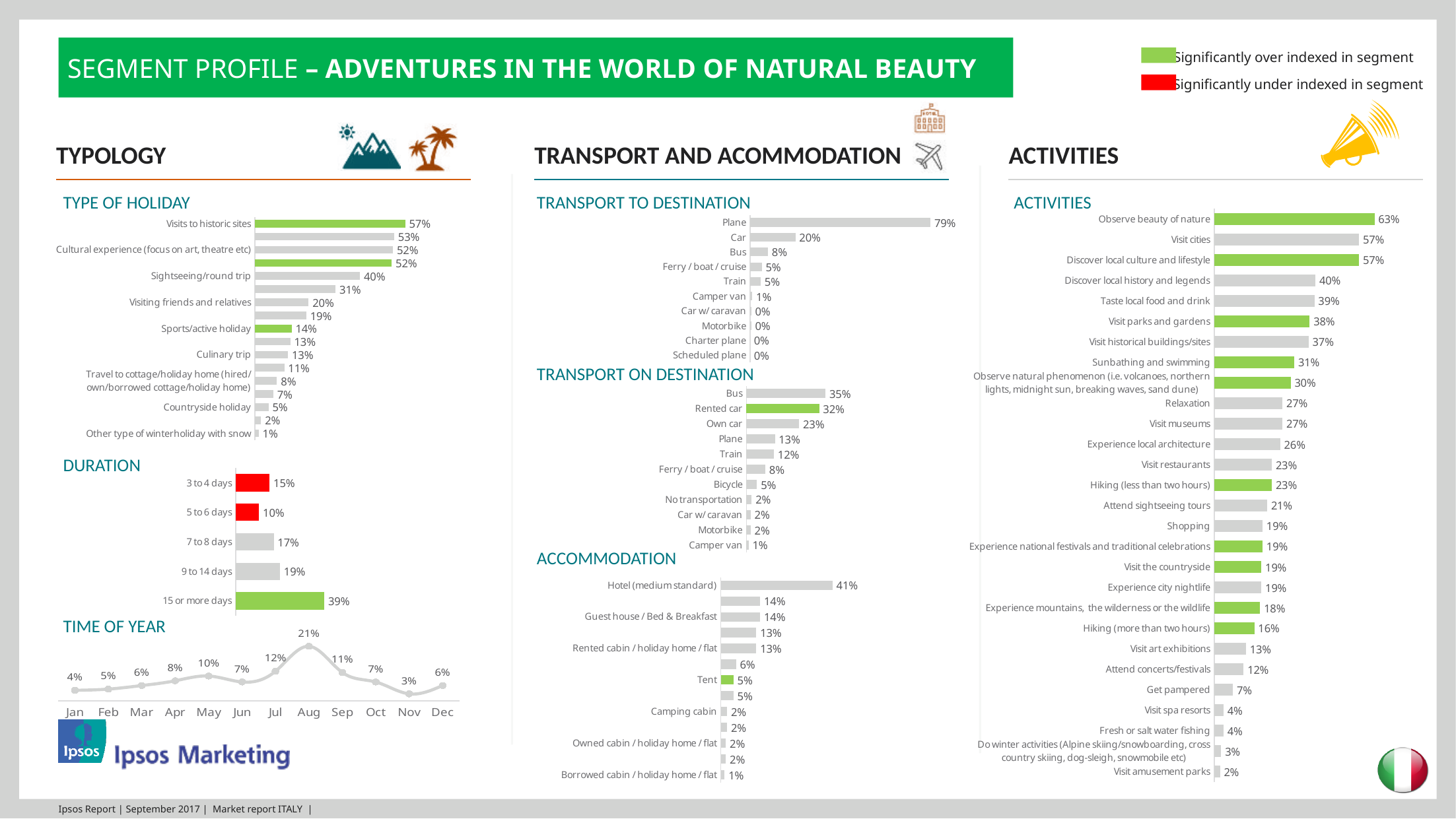
In the ACTIVITIES chart, which activity has the lowest value? Visit amusement parks How many categories does the DURATION chart show? 5 What kind of chart is the TIME OF YEAR chart? Line chart In the TRANSPORT TO DESTINATION chart, what is the difference between Plane and Car? 59% In the TIME OF YEAR chart, which month has the highest value? Aug In the DURATION chart, which category has the lowest value? 5 to 6 days In the TIME OF YEAR chart, what is the value for Nov? 3% In the TYPE OF HOLIDAY chart, what is the value for Sports/active holiday? 14% In the ACCOMMODATION chart, what is the value for Hotel (medium standard)? 41% In the DURATION chart, what is the value for 15 or more days? 39% In the ACTIVITIES chart, what is the value for Observe beauty of nature? 63% In the TRANSPORT ON DESTINATION chart, which is larger, Bus or Rented car? Bus